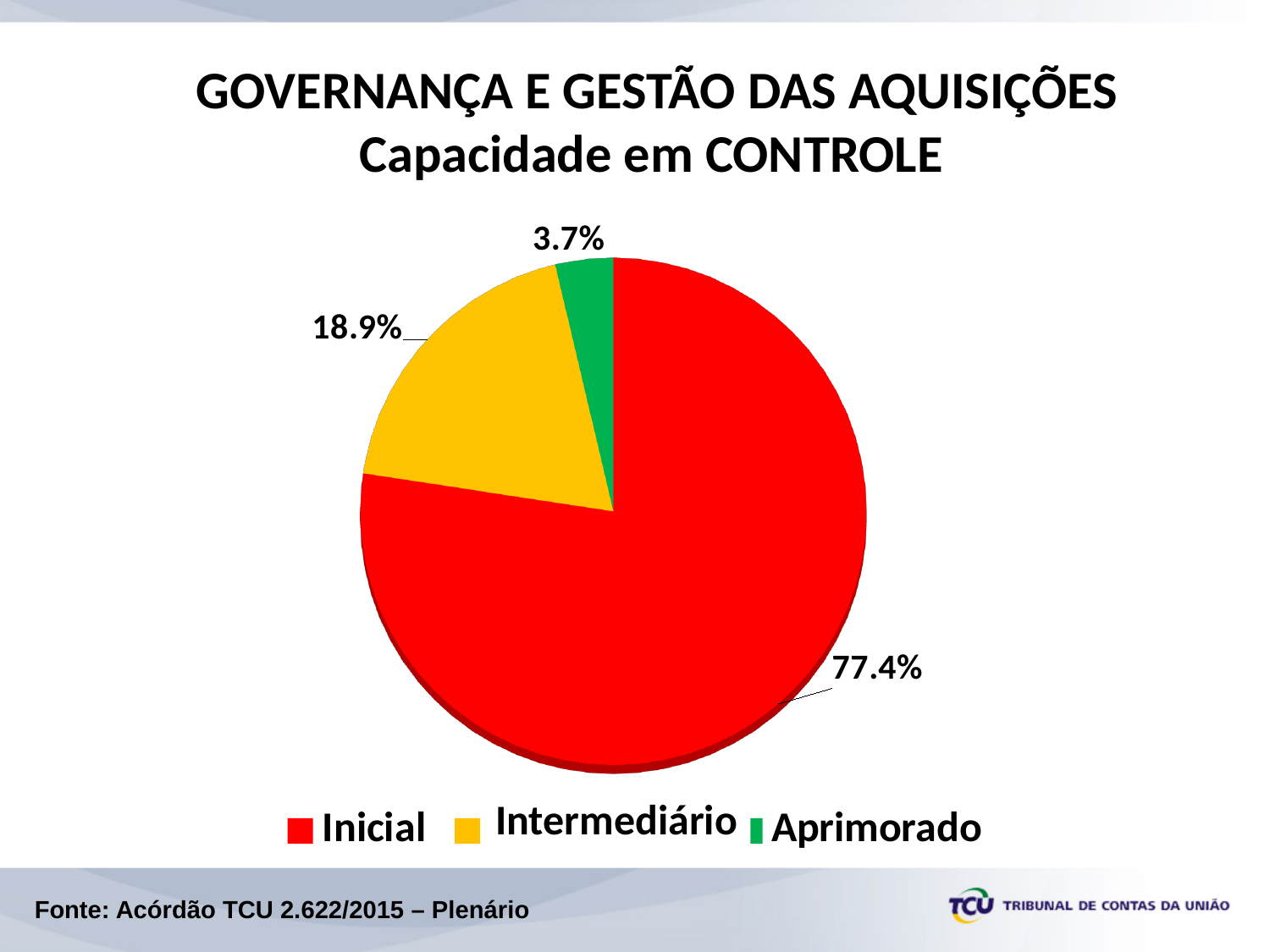
What is the difference in percentage points between the Inicial and Intermediário slices? 58.5 What percentage of the pie is labelled Aprimorado? 3.7% What percentage of the pie is labelled Intermediário? 18.9% Which category has the smallest slice of the pie? Aprimorado What colour is the Aprimorado slice? Green Which category has the largest slice of the pie? Inicial What is the source cited at the bottom of the slide? Acórdão TCU 2.622/2015 – Plenário What kind of chart is shown on the slide? Pie chart What percentage of the pie is labelled Inicial? 77.4% Which slice is larger, Intermediário or Aprimorado? Intermediário What is the difference in percentage points between the Intermediário and Aprimorado slices? 15.2 How many slices does the pie chart have? 3